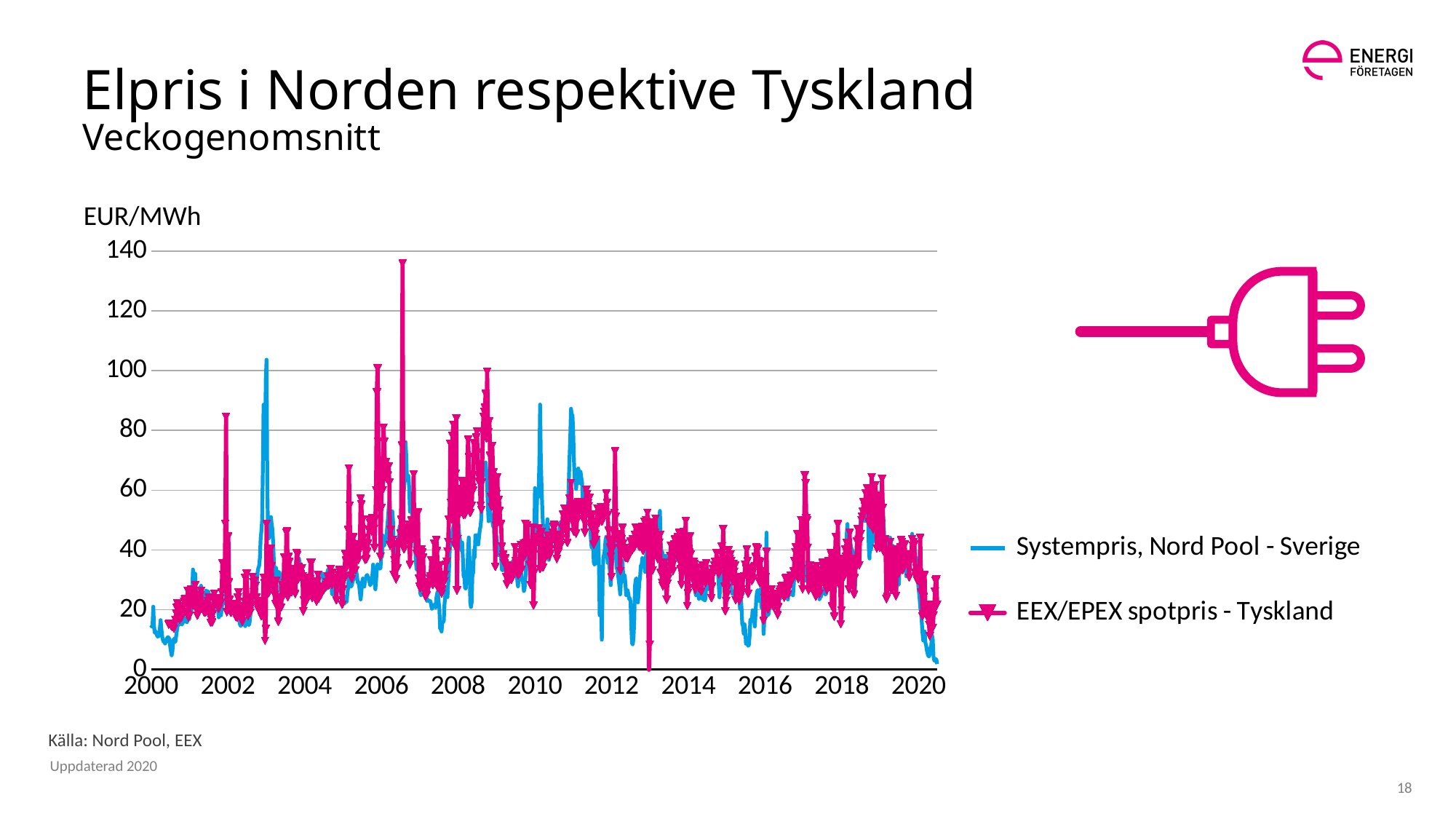
Which series has the higher peak around 2006: Systempris, Nord Pool - Sverige or EEX/EPEX spotpris - Tyskland? EEX/EPEX spotpris - Tyskland Which series reaches the highest peak in the chart? EEX/EPEX spotpris - Tyskland Is the highest peak of the EEX/EPEX spotpris - Tyskland series greater or less than 120? greater Is the highest peak of the Systempris, Nord Pool - Sverige series greater or less than 120? less Is the value of Systempris, Nord Pool - Sverige at the end of the series in 2020 greater or less than 20? less How many series does the chart legend list? 2 What are the two series named in the chart legend? Systempris, Nord Pool - Sverige; EEX/EPEX spotpris - Tyskland What is the highest value shown on the y axis of the chart? 140 Which series has the higher peak around 2003: Systempris, Nord Pool - Sverige or EEX/EPEX spotpris - Tyskland? Systempris, Nord Pool - Sverige What kind of chart is shown on the slide? line chart What unit is shown on the y axis of the chart? EUR/MWh